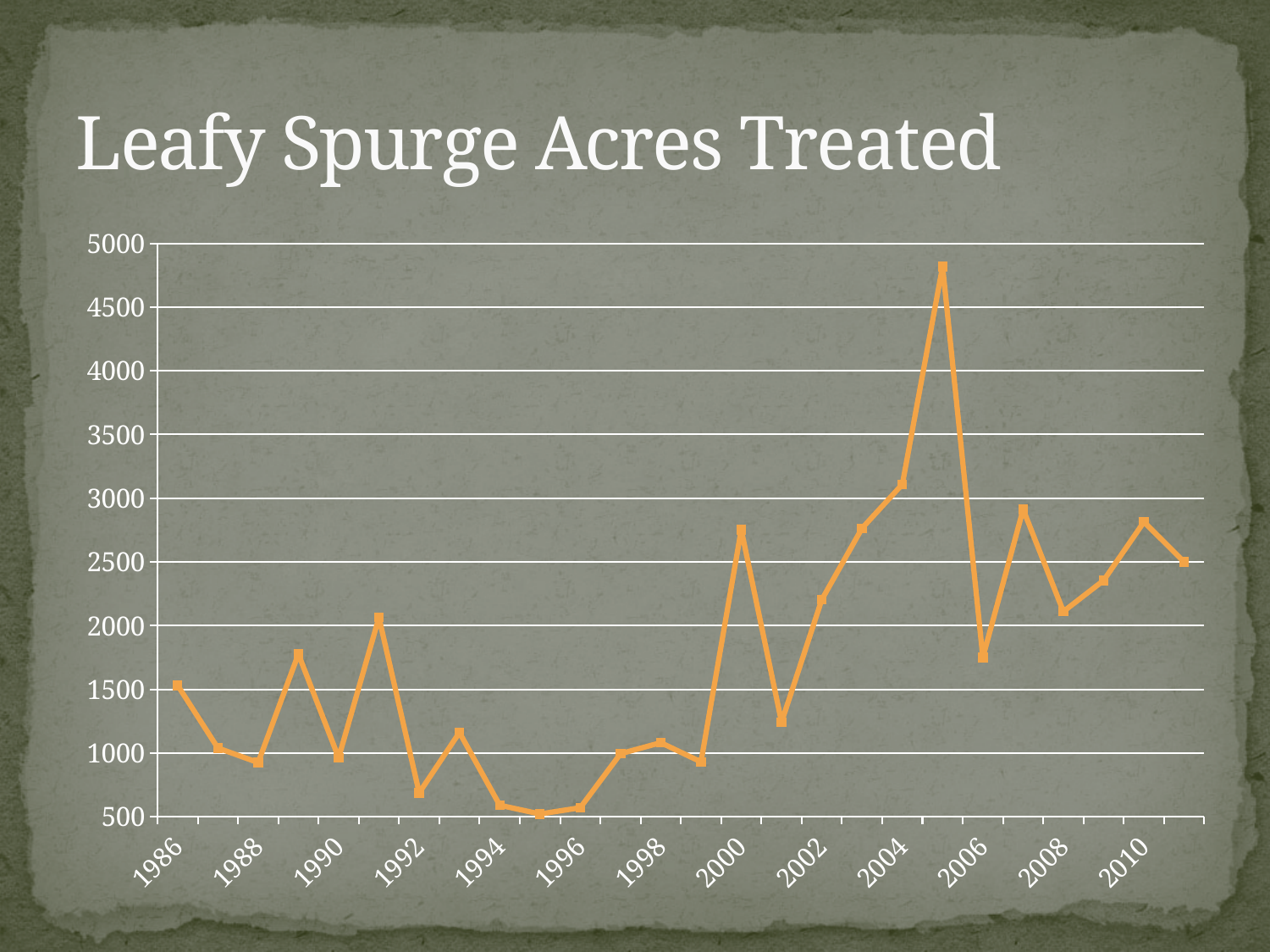
Is the value for 1992 greater or less than 1000? less In which year were the most acres treated? 2005 How many year labels are shown on the x axis? 13 What is the title of the chart? Leafy Spurge Acres Treated Is the value for 2005 greater or less than 4500? greater Do the values rise or fall from 2001 to 2005? rise Is the value for 2010 greater or less than 2500? greater What kind of chart is shown on the slide? line chart Which year has the larger value, 1990 or 1991? 1991 Which year has the larger value, 2000 or 2001? 2000